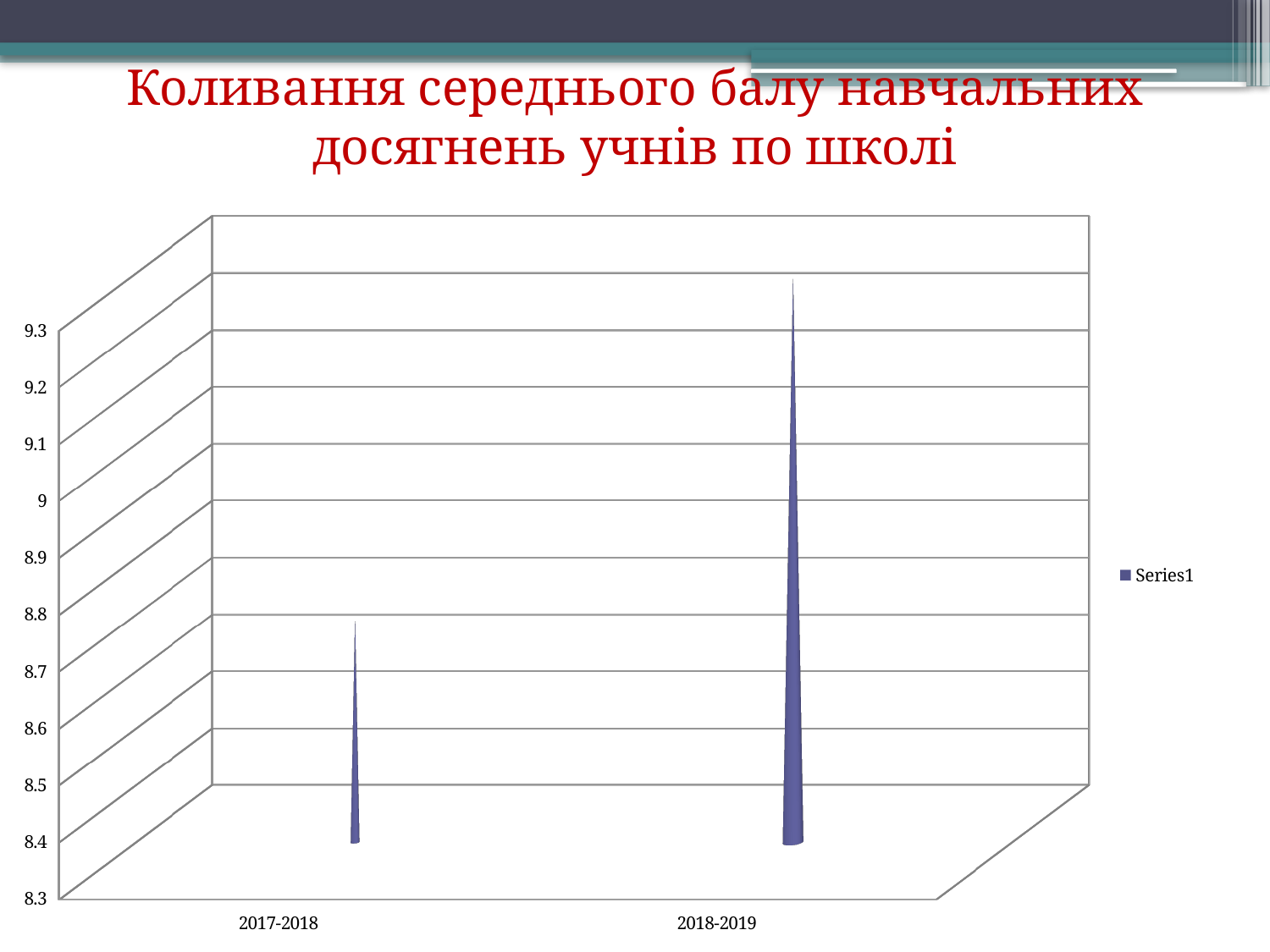
Is the value for 2017-2018 greater or less than 8.5? greater What kind of chart is shown on the slide? bar chart Which category has the lowest value? 2017-2018 Is the value for 2018-2019 greater or less than 9? greater Do the values rise or fall from 2017-2018 to 2018-2019? rise What is the name of the series shown in the legend? Series1 Which category has the higher value, 2017-2018 or 2018-2019? 2018-2019 Which category has the highest value? 2018-2019 Is the value for 2017-2018 greater or less than 9? less How many series does the legend list? 1 What is the title of the slide above the chart? Коливання середнього балу навчальних досягнень учнів по школі How many categories are shown on the x axis of the chart? 2